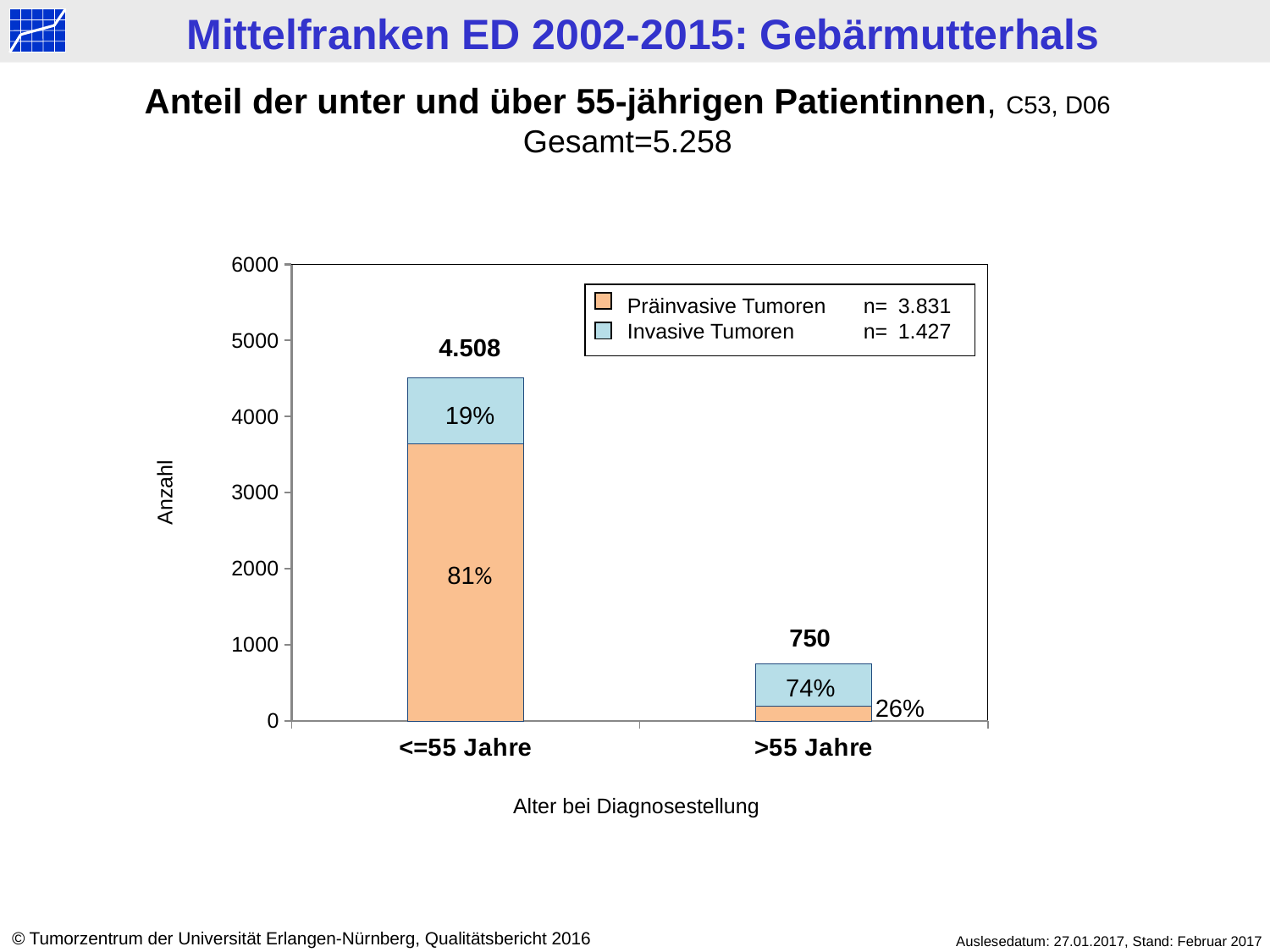
What is the n value given in the legend for Präinvasive Tumoren? 3.831 What percentage of the >55 Jahre bar is Präinvasive Tumoren? 26% What is the difference between the totals of the <=55 Jahre and >55 Jahre bars? 3.758 What percentage of the <=55 Jahre bar is Invasive Tumoren? 19% What is the total number of patients shown for the <=55 Jahre bar? 4.508 How many series does the legend list? 2 What is the total number of patients shown for the >55 Jahre bar? 750 Which age group has the higher total number of patients? <=55 Jahre What percentage of the <=55 Jahre bar is Präinvasive Tumoren? 81% How many age categories are shown on the x axis? 2 What percentage of the >55 Jahre bar is Invasive Tumoren? 74% Is the total for the >55 Jahre bar greater or less than 1000? less